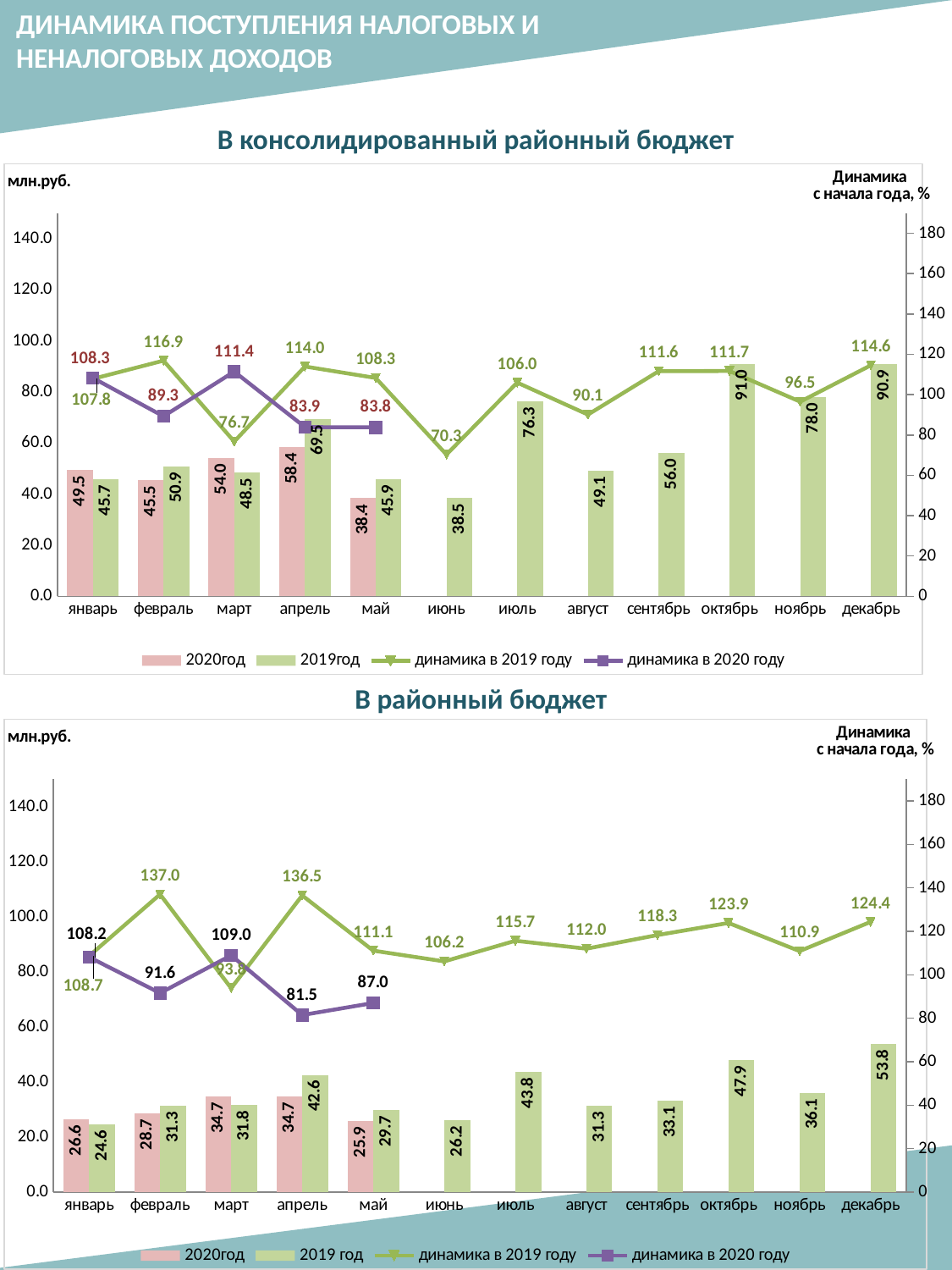
On the chart 'В консолидированный районный бюджет', what is the value of 'динамика в 2020 году' for май? 83.8 On the chart 'В районный бюджет', which is larger for май: the 2020 год bar or the 2019 год bar? 2019 год On the chart 'В консолидированный районный бюджет', how many series does the legend list? 4 On the chart 'В районный бюджет', which month has the highest 'динамика в 2019 году' value? февраль On the chart 'В консолидированный районный бюджет', what is the difference between the 2020 год and 2019 год bars for март? 5.5 On the chart 'В районный бюджет', what is the value of the 2019 год bar for декабрь? 53.8 On the chart 'В консолидированный районный бюджет', what is the value of the 2019 год bar for октябрь? 91.0 On the chart 'В районный бюджет', what is the difference between the 2019 год bars for апрель and май? 12.9 On the chart 'В консолидированный районный бюджет', what is the value of the 2020 год bar for апрель? 58.4 On the chart 'В районный бюджет', how many months are shown on the x axis? 12 On the chart 'В консолидированный районный бюджет', which month has the lowest 2019 год bar? июнь What kind of chart is 'В районный бюджет'? Combined bar and line chart